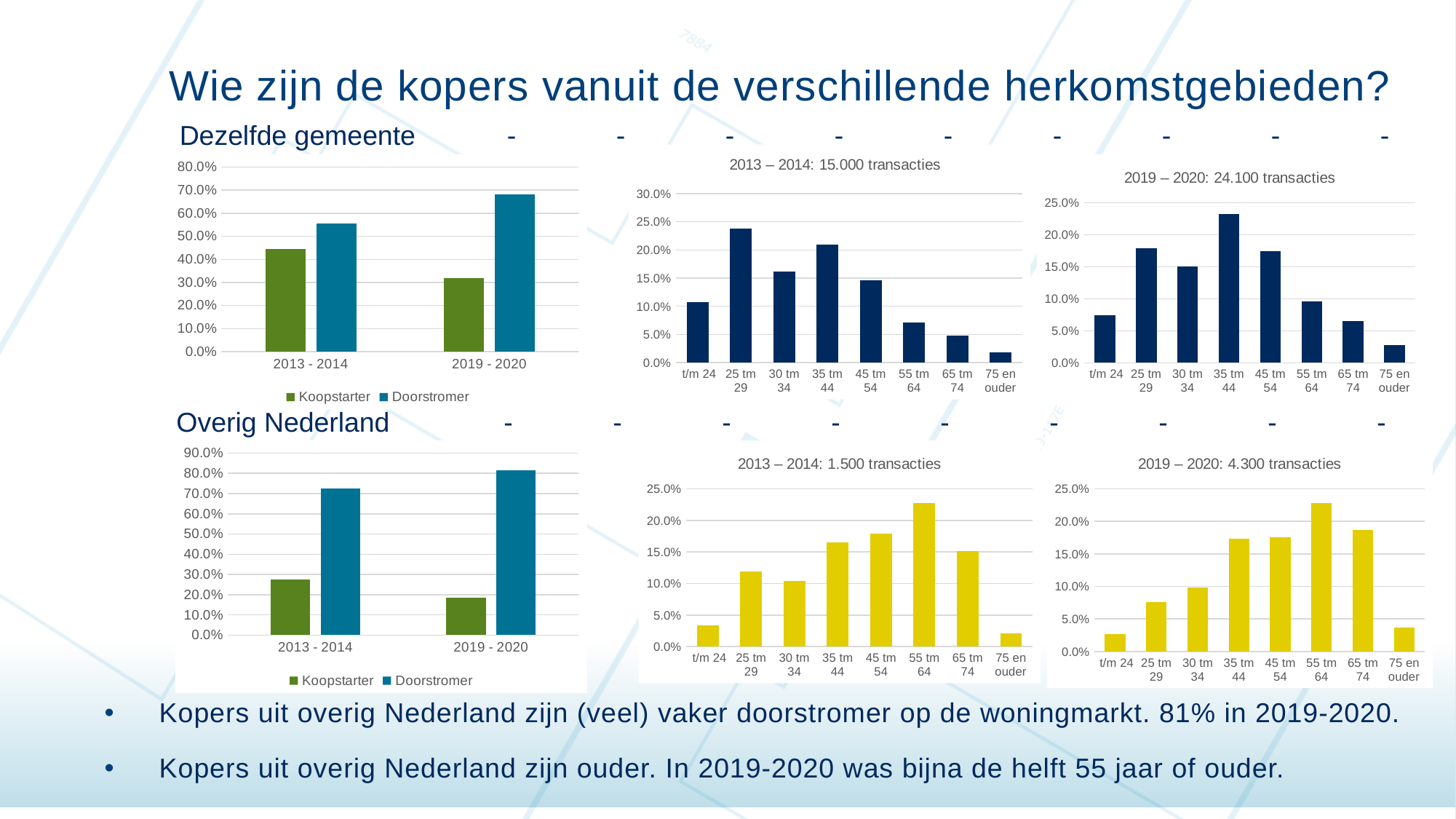
How many age groups are shown on the x axis of the chart titled '2019 – 2020: 4.300 transacties'? 8 In the chart titled '2019 – 2020: 24.100 transacties', which age group has the highest value? 35 tm 44 In the chart titled '2013 – 2014: 1.500 transacties', which age group has the highest value? 55 tm 64 In the 'Dezelfde gemeente' chart, which series has the larger value for 2013 - 2014, Koopstarter or Doorstromer? Doorstromer What kind of chart is the chart titled '2019 – 2020: 4.300 transacties'? bar chart In the 'Overig Nederland' chart, is the Doorstromer value for 2019 - 2020 greater or less than 80.0%? greater In the 'Overig Nederland' chart, is the Koopstarter value for 2013 - 2014 greater or less than 30.0%? less In the chart titled '2013 – 2014: 15.000 transacties', which age group has the highest value? 25 tm 29 In the 'Dezelfde gemeente' chart, is the Doorstromer value for 2019 - 2020 greater or less than 60.0%? greater How many series does the legend of the 'Overig Nederland' chart list? 2 In the chart titled '2013 – 2014: 15.000 transacties', which age group has the lowest value? 75 en ouder